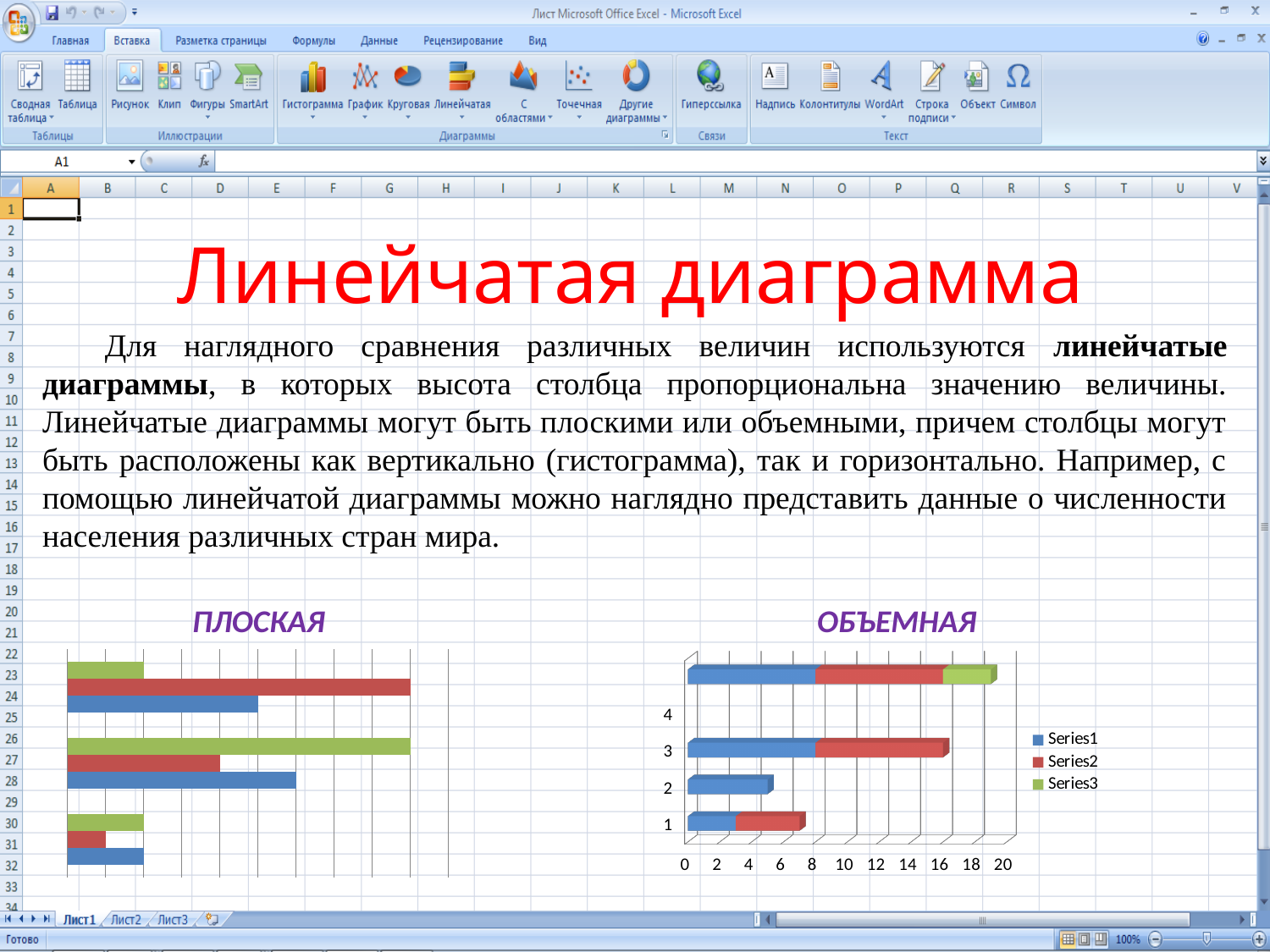
In the ОБЪЕМНАЯ chart, is the total length of the bar for category 2 greater or less than 8? less In the ОБЪЕМНАЯ chart, how many series does the legend list? 3 In the ОБЪЕМНАЯ chart, how many categories are shown on the vertical axis? 4 In the ОБЪЕМНАЯ chart, what is the highest value shown on the horizontal axis? 20 What kind of chart is the ПЛОСКАЯ chart on the left? bar chart In the ОБЪЕМНАЯ chart, is the total length of the bar for category 1 greater or less than 10? less In the ОБЪЕМНАЯ chart, which category has the shortest stacked bar? 2 In the ОБЪЕМНАЯ chart, which stacked bar is longer, category 3 or category 1? category 3 What kind of chart is the ОБЪЕМНАЯ chart on the right? bar chart